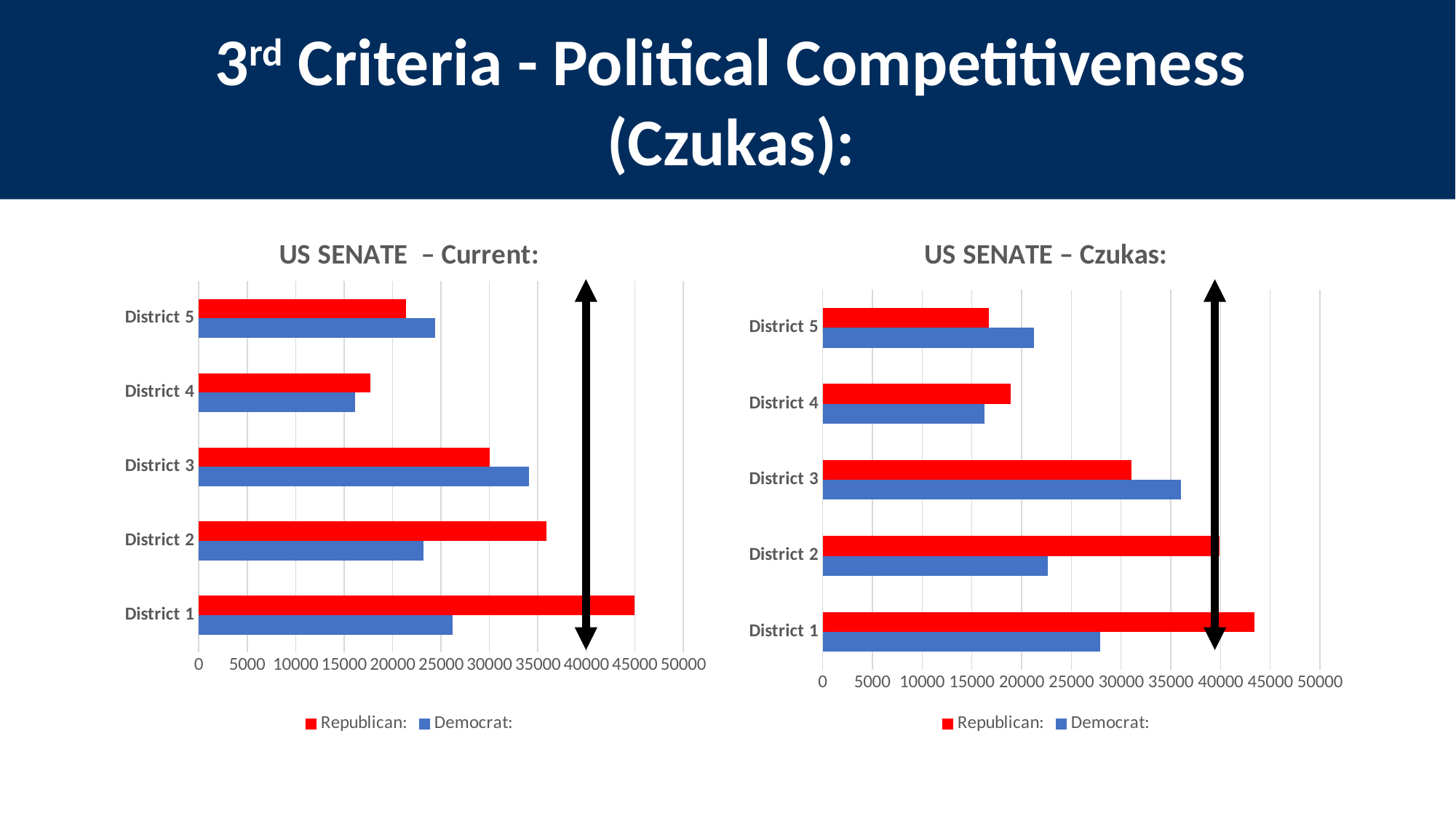
In the US SENATE – Current chart, is the Democrat value for District 4 greater or less than 20000? less In the US SENATE – Current chart, what kind of chart is shown? bar chart In the US SENATE – Current chart, is the Republican value for District 1 greater or less than 40000? greater In the US SENATE – Current chart, how many districts are plotted? 5 In the US SENATE – Czukas chart, which district has the lowest Democrat value? District 4 In the US SENATE – Czukas chart, what colour represents the Republican series? red In the US SENATE – Current chart, how many series does the legend list? 2 In the US SENATE – Current chart, for District 2, is the Republican or the Democrat value larger? Republican In the US SENATE – Czukas chart, is the Republican value for District 2 greater or less than 35000? greater In the US SENATE – Current chart, which district has the highest Republican value? District 1 In the US SENATE – Current chart, which district has the lowest Democrat value? District 4 In the US SENATE – Czukas chart, for District 3, is the Republican or the Democrat value larger? Democrat